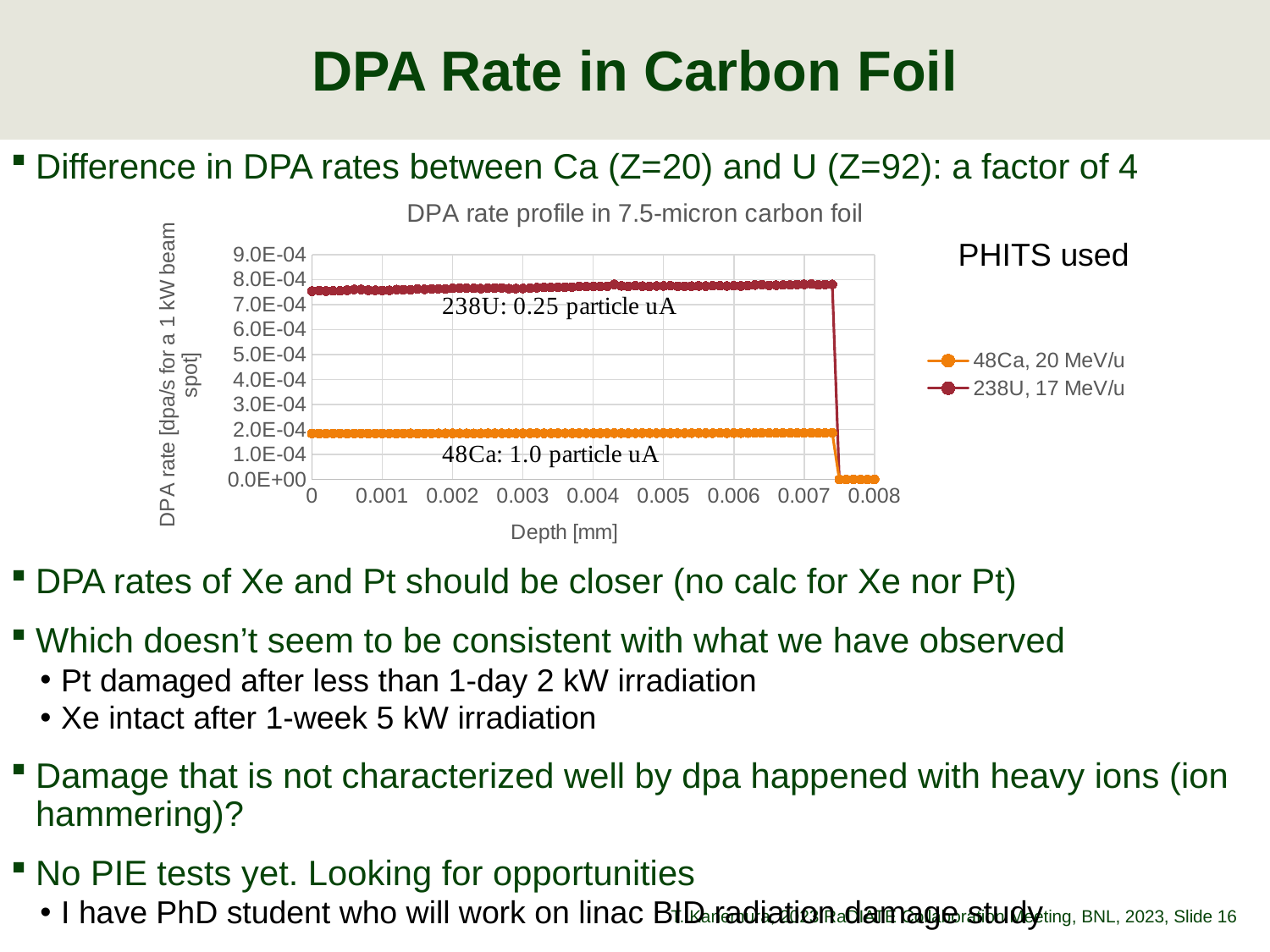
Which series has the higher DPA rate across the foil, 48Ca or 238U? 238U, 17 MeV/u Is the DPA rate for 238U at a depth of 0.005 mm greater or less than 9.0E-04? less How many series does the chart legend list? 2 What are the two series named in the chart legend? 48Ca, 20 MeV/u and 238U, 17 MeV/u Is the DPA rate for 48Ca at a depth of 0.004 mm greater or less than 3.0E-04? less What is the highest value shown on the y axis? 9.0E-04 What kind of chart is shown on the slide? Line chart What is the label of the x axis? Depth [mm] Is the DPA rate for 238U at a depth of 0.002 mm greater or less than 5.0E-04? greater How does the DPA rate for 238U change along the depth axis? Stays roughly flat, then drops sharply to zero near 0.0075 mm